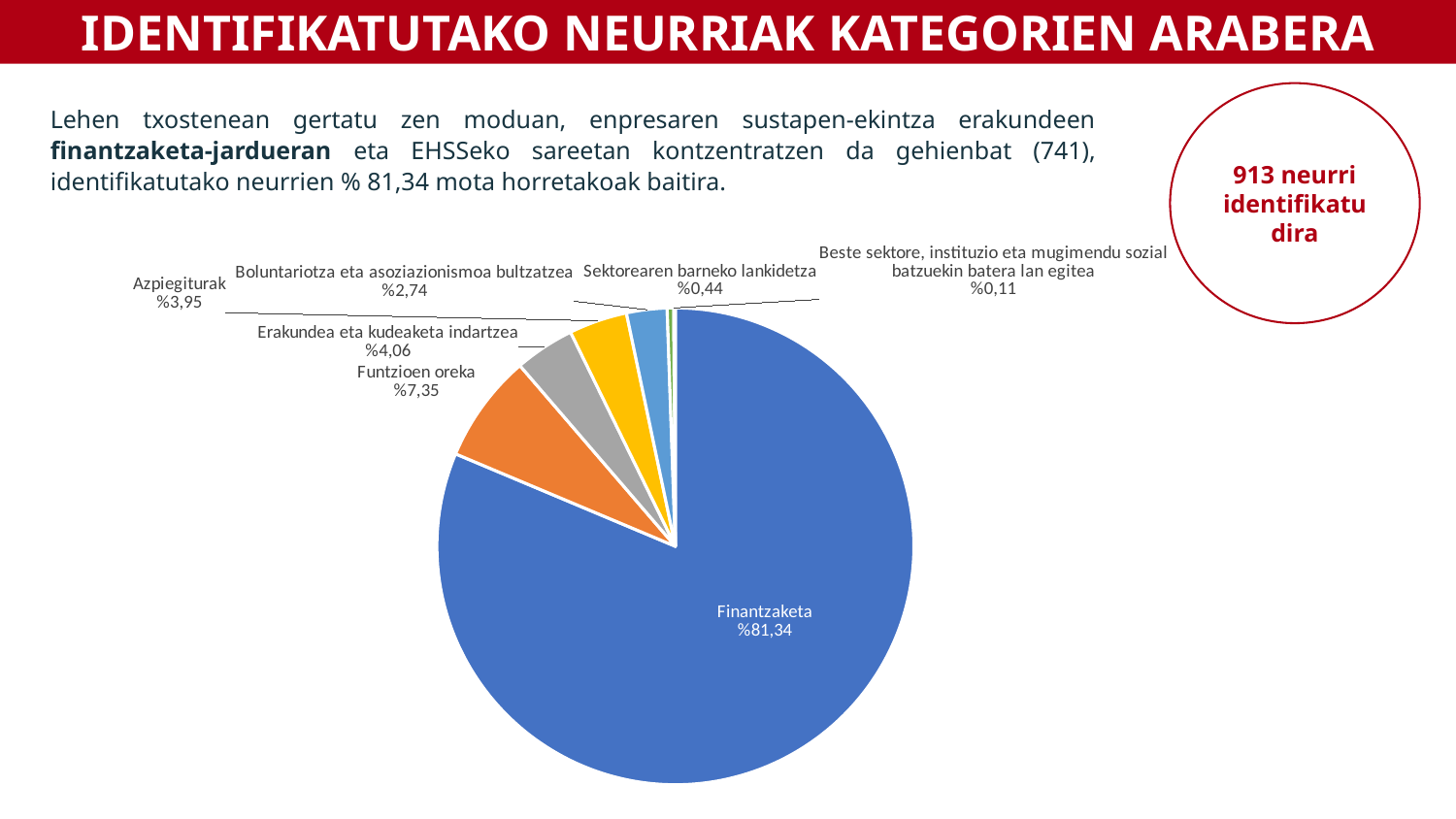
Which category has the largest slice of the pie? Finantzaketa What colour is the Finantzaketa slice? Blue Which category has the smallest slice of the pie? Beste sektore, instituzio eta mugimendu sozial batzuekin batera lan egitea What share of the pie does Finantzaketa have? %81,34 What is the value shown for Erakundea eta kudeaketa indartzea? %4,06 Which is larger, Funtzioen oreka or Boluntariotza eta asoziazionismoa bultzatzea? Funtzioen oreka What is the value shown for Azpiegiturak? %3,95 What is the difference between the values for Funtzioen oreka and Azpiegiturak? %3,40 How many categories are shown in the pie chart? 7 What is the value shown for Sektorearen barneko lankidetza? %0,44 What kind of chart is shown on the slide? Pie chart What is the value shown for Funtzioen oreka? %7,35